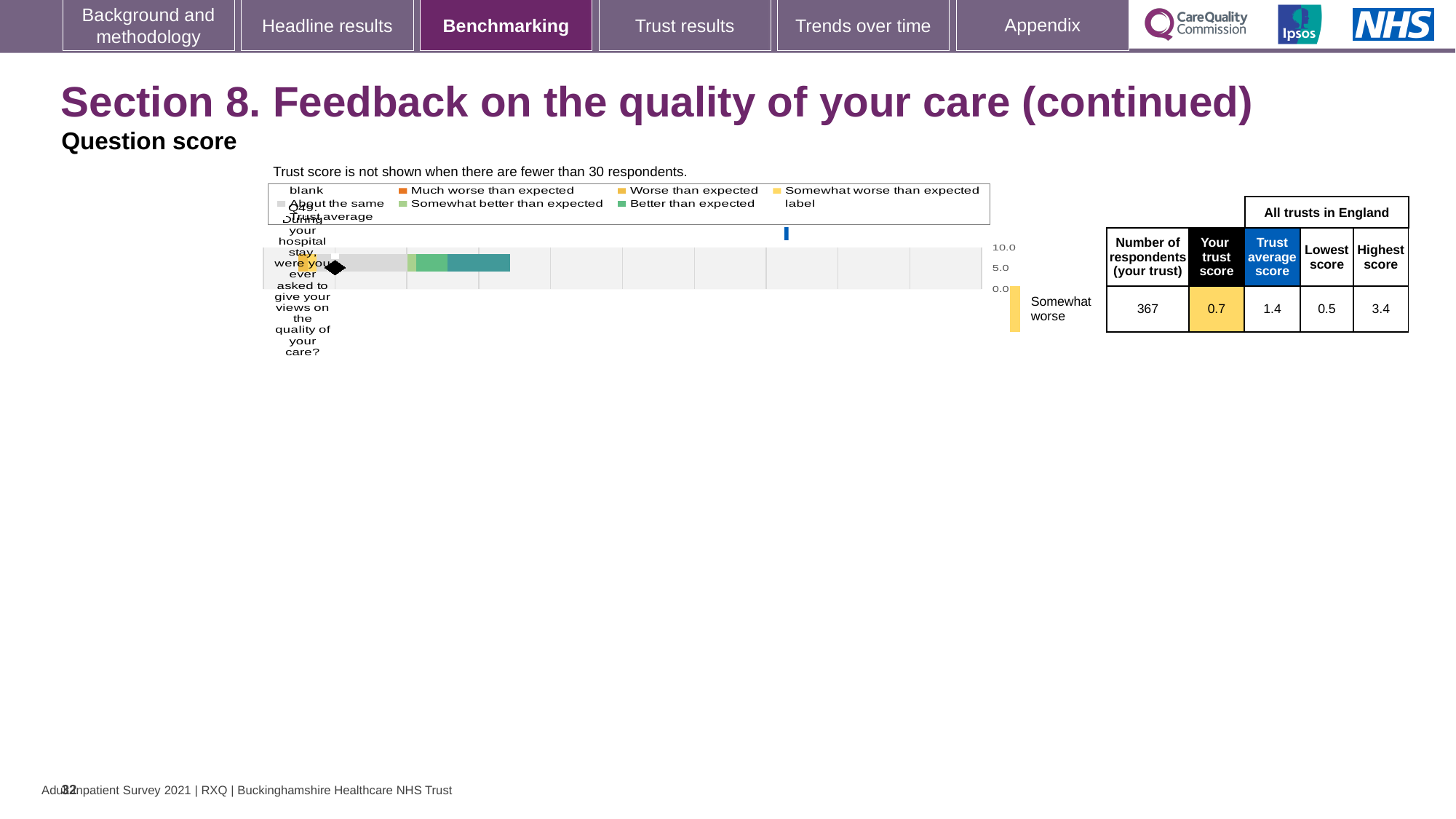
How many respondents from the trust answered Q49? 367 Which benchmarking category is the trust's Q49 result placed in? Somewhat worse What is the trust score for Q49 (Your trust score)? 0.7 What is the highest score among all trusts in England for Q49? 3.4 What kind of chart is used to show the benchmarking result for Q49? bar chart What is the difference between the highest score and the lowest score for Q49? 2.9 Is the trust's score for Q49 greater or less than 5.0? less What is the highest value shown on the chart's numeric axis? 10.0 What is the trust average score for Q49 across all trusts in England? 1.4 What is the lowest score among all trusts in England for Q49? 0.5 Which is larger for Q49: the trust's own score or the trust average score? Trust average score What is the difference between the trust average score and the trust's own score for Q49? 0.7